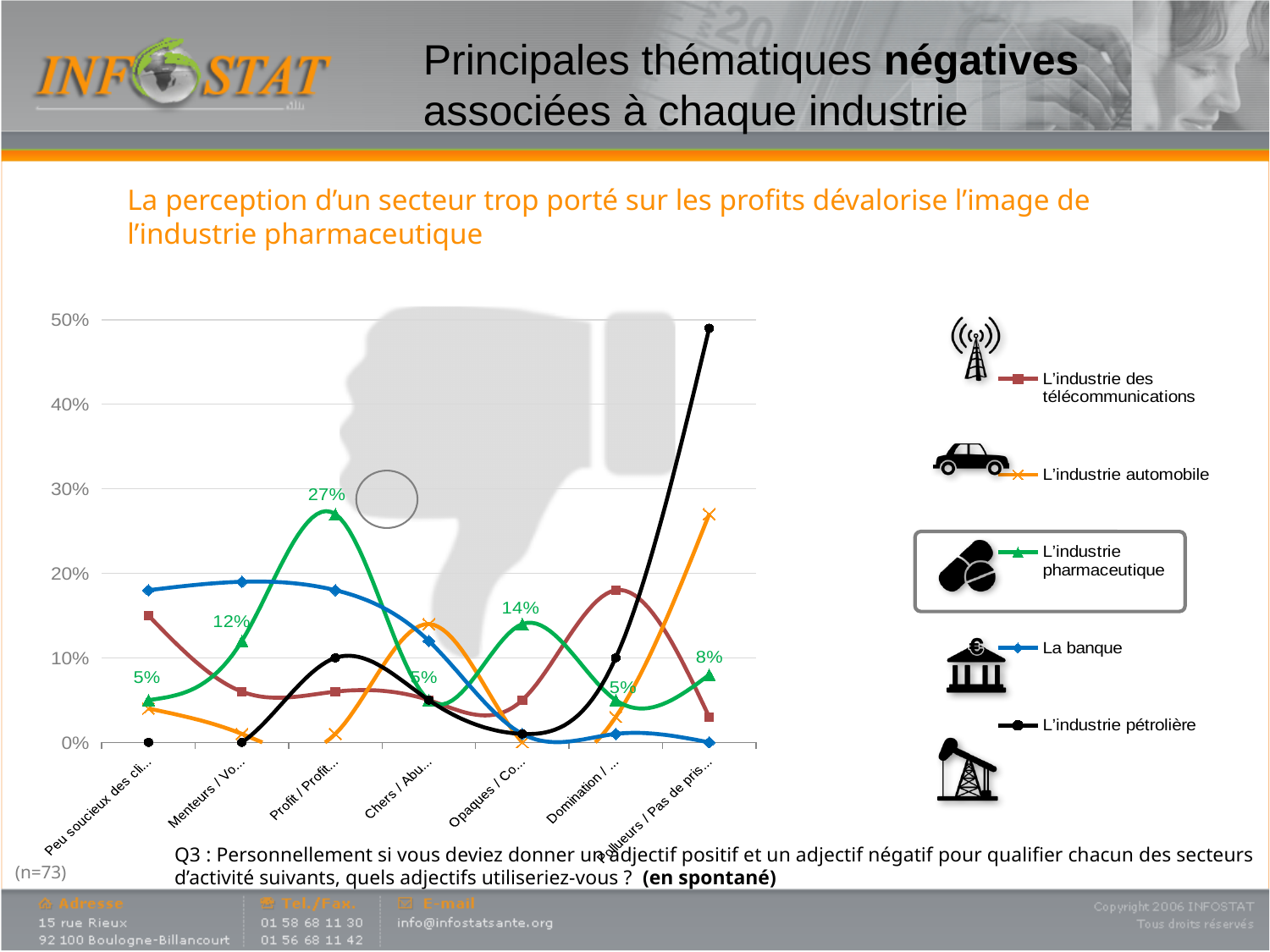
Is the value for L'industrie pétrolière at the last category on the x axis greater or less than 40%? greater Which legend entry is highlighted with a box around it? L'industrie pharmaceutique At the category "Profit / Profit...", which series has the larger value: L'industrie pharmaceutique or La banque? L'industrie pharmaceutique What is the value for L'industrie pharmaceutique at the category "Opaques / Co..."? 14% What is the value for L'industrie pharmaceutique at the category "Menteurs / Vo..."? 12% Which series reaches the highest value anywhere on the chart? L'industrie pétrolière What kind of chart is shown on the slide? line chart At which category does L'industrie pharmaceutique reach its highest value? Profit / Profit... How many series does the legend list? 5 How many categories are shown along the x axis? 7 What is the value for L'industrie pharmaceutique at the category "Profit / Profit..."? 27% What is the difference between the L'industrie pharmaceutique values at "Profit / Profit..." and "Opaques / Co..."? 13 percentage points